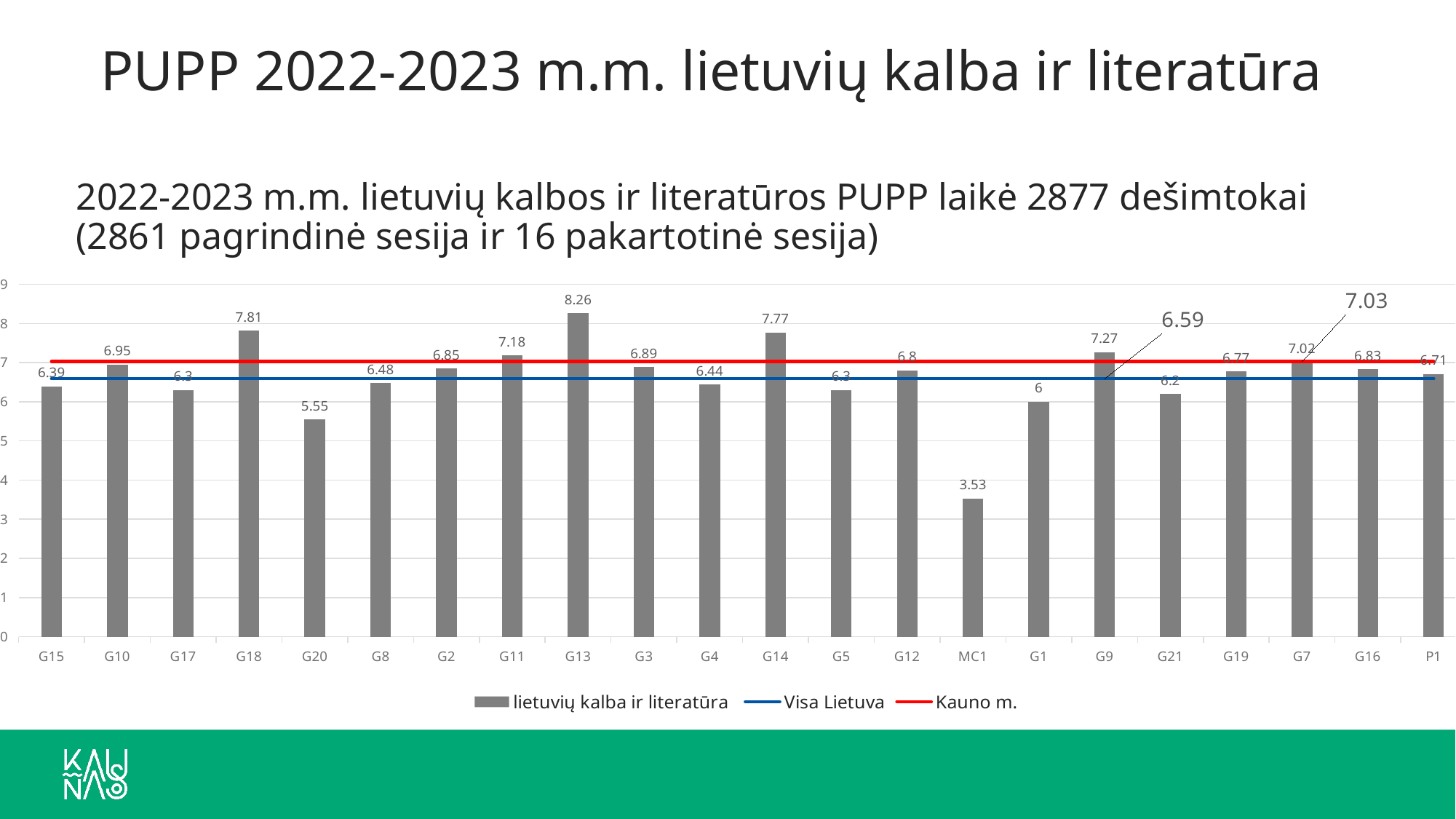
How many series does the legend list? 3 What value is labelled on the Visa Lietuva line? 6.59 Which category has the highest bar? G13 What is the difference between the values for G18 and G14? 0.04 Which is larger, the value for G9 or the value for G11? G9 What value is labelled on the Kauno m. line? 7.03 How many categories are shown on the x axis? 22 What is the value for MC1? 3.53 Which category has the lowest bar? MC1 What kind of chart is this? combination bar and line chart What is the value for G13? 8.26 What is the value for G20? 5.55